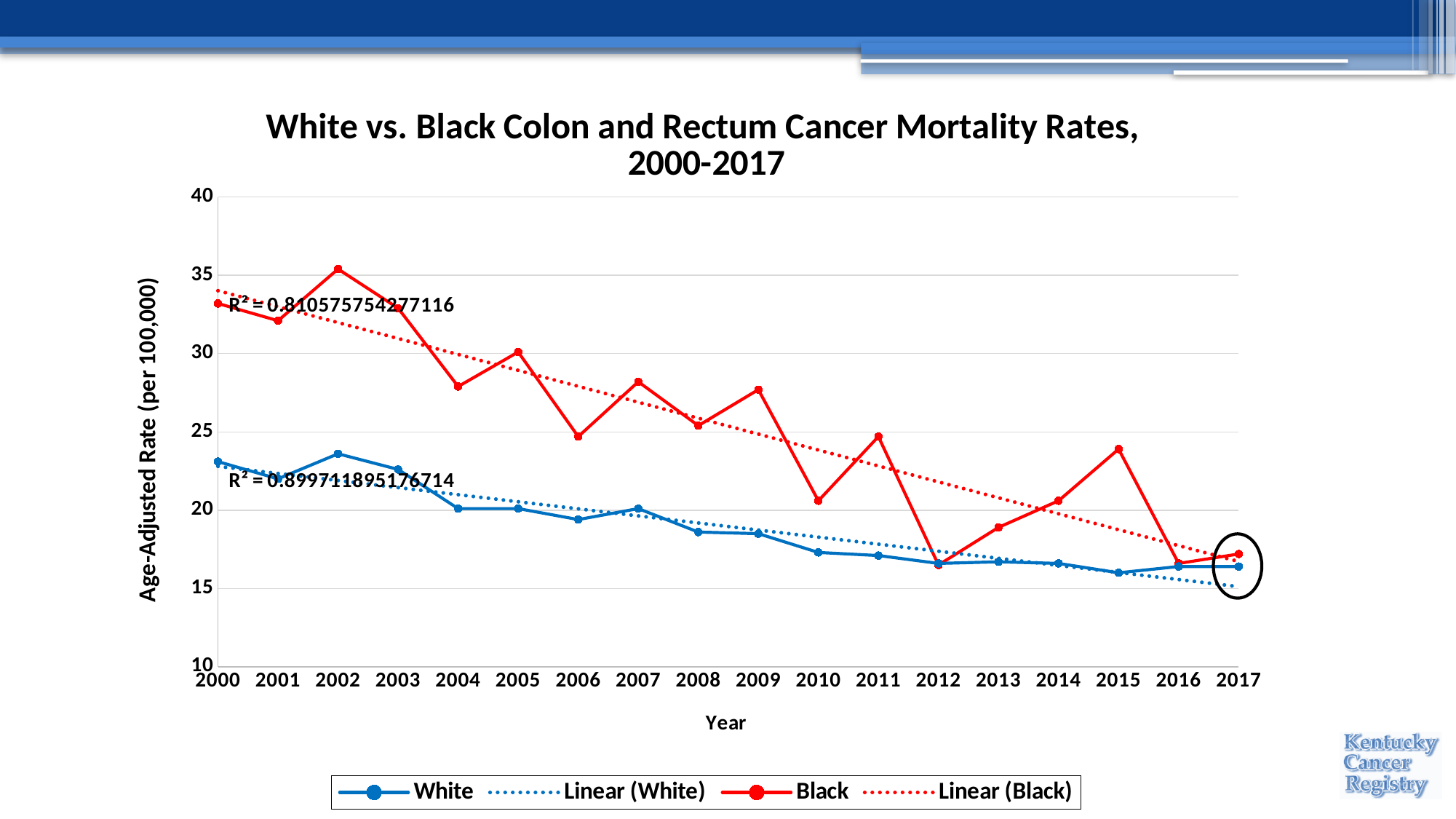
Is the value for Black in 2012 greater or less than 20? less What is the label of the y axis? Age-Adjusted Rate (per 100,000) Is the value for Black in 2015 greater or less than 25? less How many entries does the legend list? 4 Is the value for Black in 2002 greater or less than 35? greater How many years are plotted along the x axis? 18 What is the R² value shown for the Black linear trendline? 0.810575754277116 In which year does the Black series reach its highest value? 2002 What kind of chart is shown on the slide? line chart Which series has the higher value in 2002, White or Black? Black Overall, do the White mortality rates rise or fall from 2000 to 2017? fall